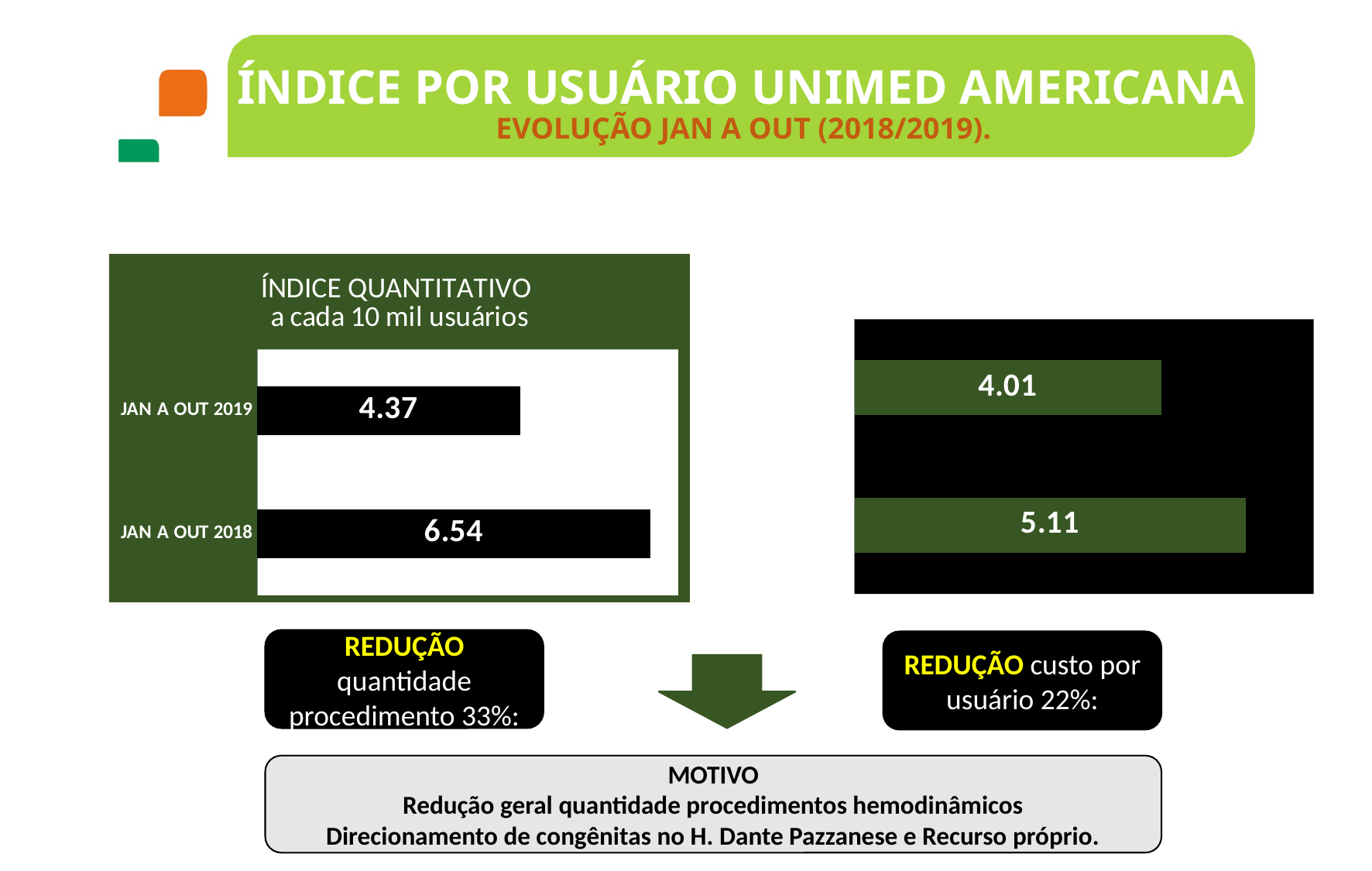
In the left chart titled 'ÍNDICE QUANTITATIVO a cada 10 mil usuários', what is the value for JAN A OUT 2019? 4.37 In the left chart titled 'ÍNDICE QUANTITATIVO a cada 10 mil usuários', what is the difference between the JAN A OUT 2018 and JAN A OUT 2019 values? 2.17 In the right chart with the black background, which bar is larger, the top bar or the bottom bar? The bottom bar In the left chart titled 'ÍNDICE QUANTITATIVO a cada 10 mil usuários', which period has the lower value? JAN A OUT 2019 In the left chart titled 'ÍNDICE QUANTITATIVO a cada 10 mil usuários', what is the value for JAN A OUT 2018? 6.54 What type of chart is the left chart titled 'ÍNDICE QUANTITATIVO a cada 10 mil usuários'? Bar chart In the left chart titled 'ÍNDICE QUANTITATIVO a cada 10 mil usuários', which period has the higher value? JAN A OUT 2018 In the right chart with the black background, how many bars are plotted? 2 In the right chart with the black background, what is the difference between the bottom bar value and the top bar value? 1.10 In the right chart with the black background, what is the value shown on the bottom bar? 5.11 In the right chart with the black background, what is the value shown on the top bar? 4.01 In the left chart titled 'ÍNDICE QUANTITATIVO a cada 10 mil usuários', how many categories are plotted? 2